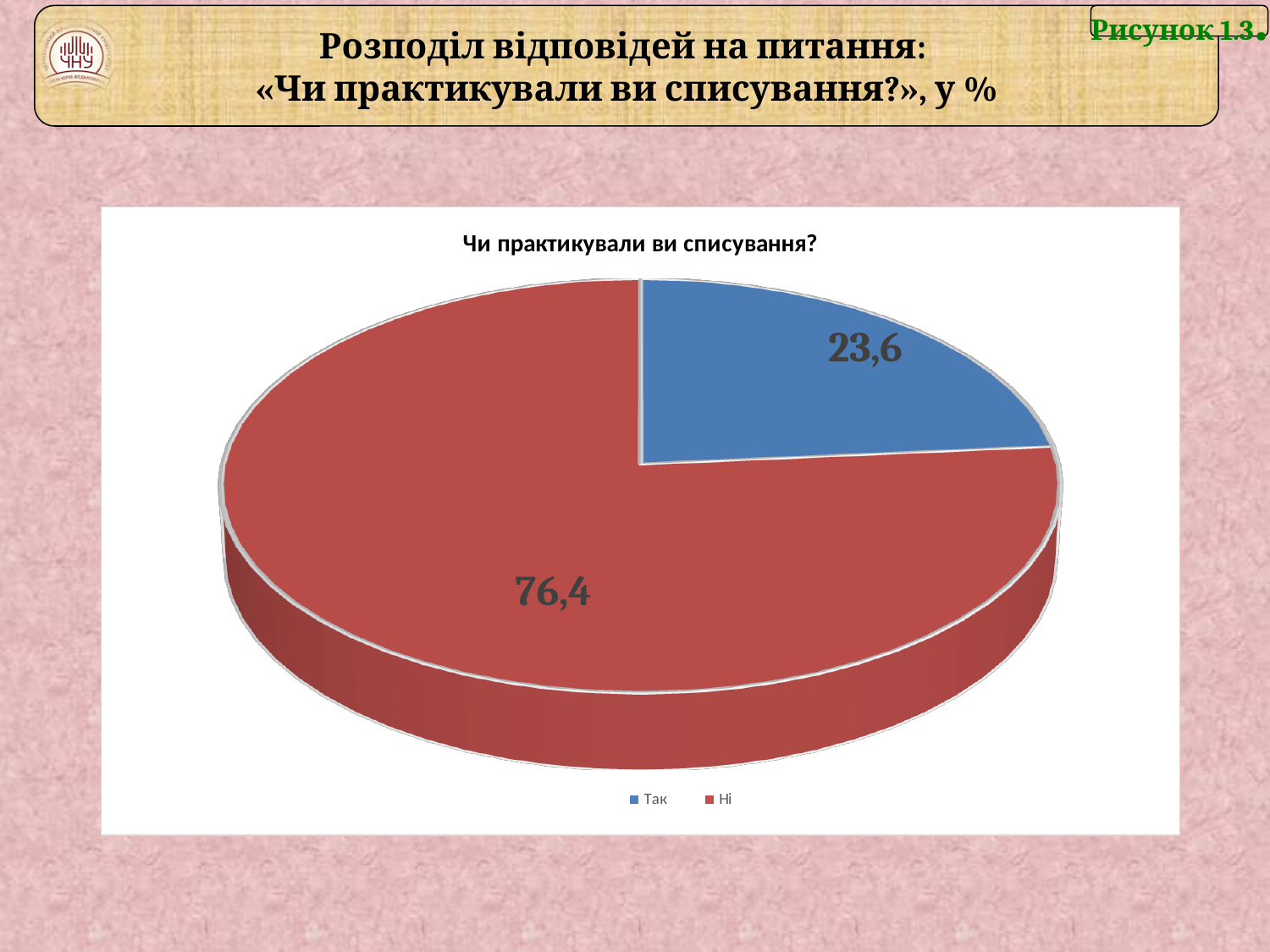
What is the difference between the values for "Ні" and "Так"? 52,8 What is the value for "Ні"? 76,4 Which category has the largest slice? Ні What is the value for "Так"? 23,6 Which is larger, the value for "Так" or the value for "Ні"? Ні What is the title of the chart? Чи практикували ви списування? How many slices does the pie chart have? 2 How many entries does the legend list? 2 What colour is the slice for "Так"? blue Which category has the smallest slice? Так What kind of chart is shown on the slide? pie chart